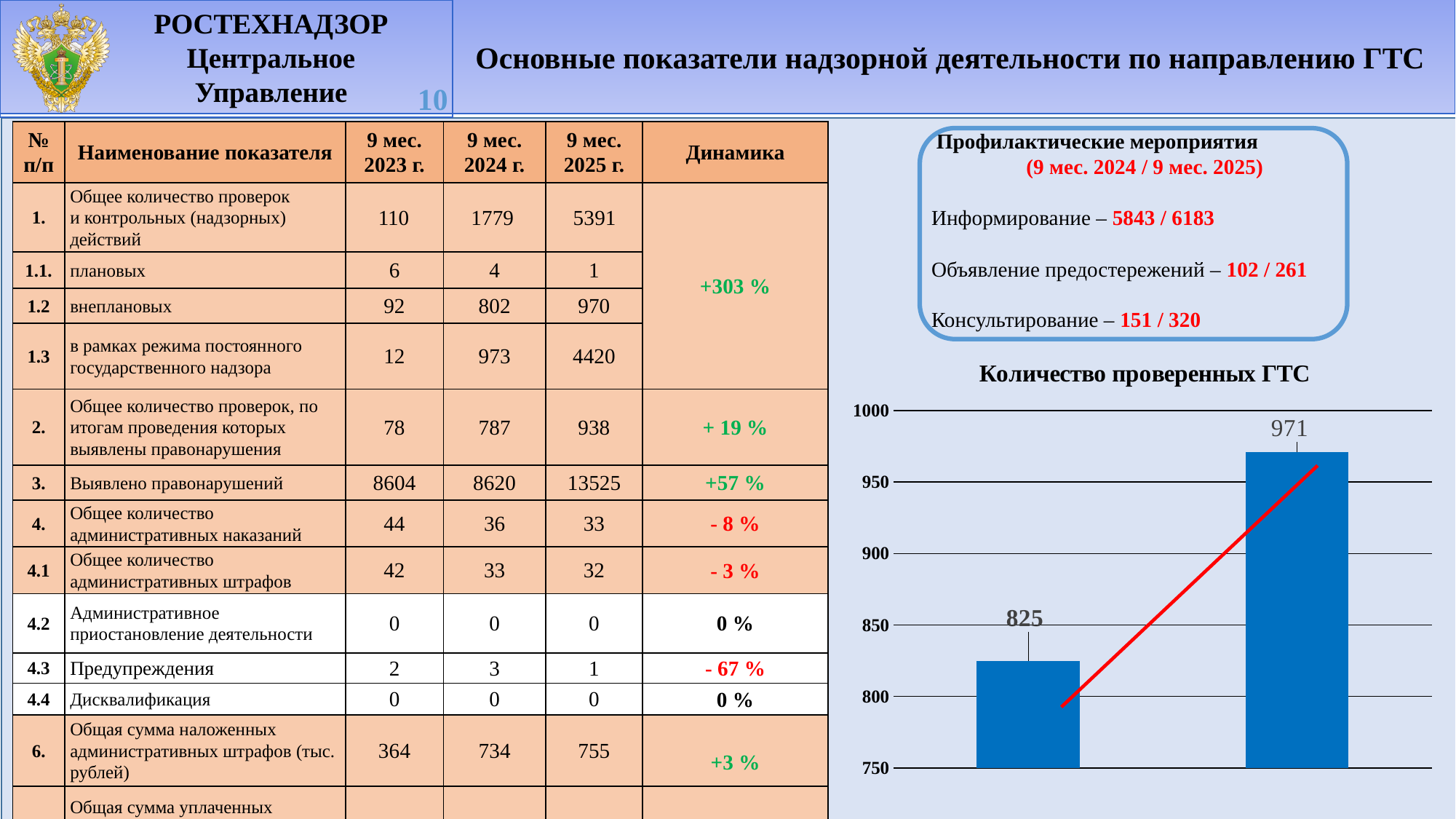
What is the highest value shown in the "Количество проверенных ГТС" chart? 971 Do the values in the "Количество проверенных ГТС" chart rise or fall from left to right? rise How many bars are plotted in the "Количество проверенных ГТС" chart? 2 What is the highest tick value on the vertical axis of the "Количество проверенных ГТС" chart? 1000 What is the title of the chart on the slide? Количество проверенных ГТС What kind of chart is shown under the title "Количество проверенных ГТС"? bar chart In the "Количество проверенных ГТС" chart, which bar is taller, the left one or the right one? the right one What is the value of the right bar in the "Количество проверенных ГТС" chart? 971 What is the lowest value shown in the "Количество проверенных ГТС" chart? 825 In the "Количество проверенных ГТС" chart, is the value of the left bar greater or less than 850? less What is the value of the left bar in the "Количество проверенных ГТС" chart? 825 What is the difference between the right bar and the left bar in the "Количество проверенных ГТС" chart? 146